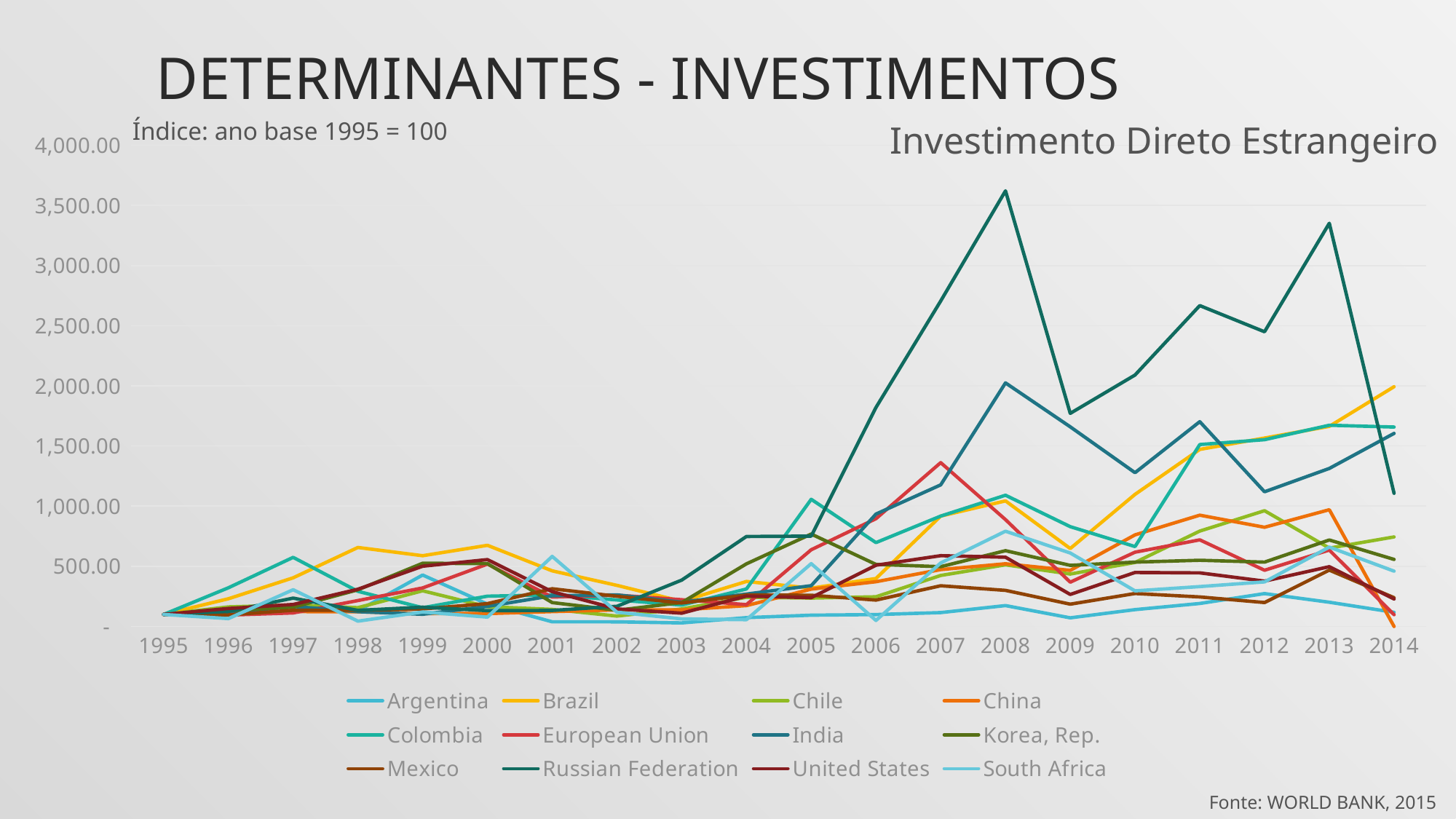
What is the title of the chart? Investimento Direto Estrangeiro Is the value for the Russian Federation in 2008 greater or less than 3,000.00? greater Is the value for Argentina in 2014 greater or less than 500.00? less Is the value for India in 2008 greater or less than 1,500.00? greater What kind of chart is shown on the slide? line chart Does the Russian Federation line rise or fall from 2013 to 2014? fall In which year does the Russian Federation line reach its peak? 2008 How many years are plotted along the x axis? 20 How many series does the legend list? 12 In 2008, which is larger: the value for the Russian Federation or the value for India? Russian Federation Which series reaches the highest value on the chart? Russian Federation